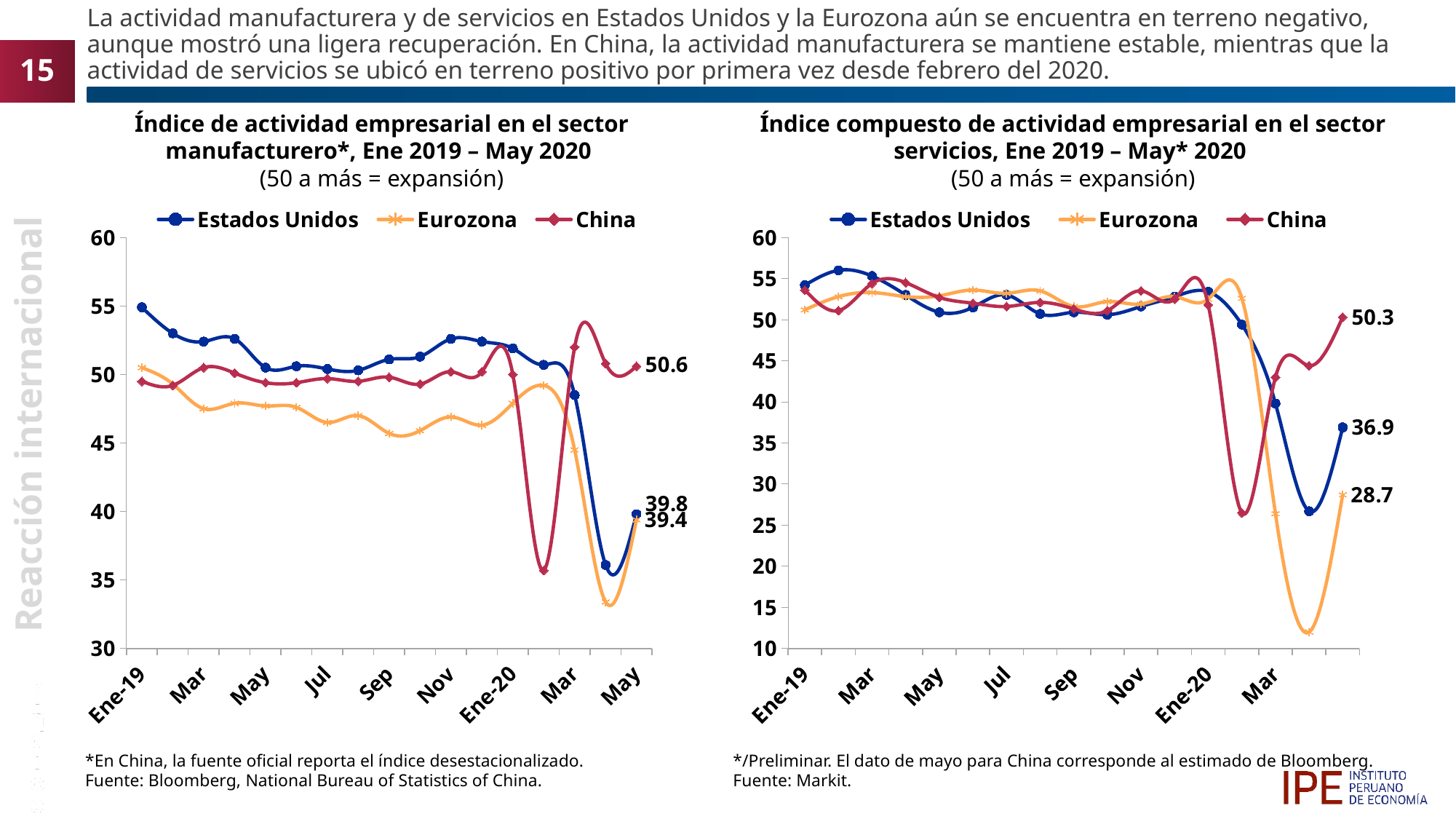
How many series does the legend of the left chart (sector manufacturero) list? 3 In the left chart (sector manufacturero), which series has the highest value in May 2020? China In the left chart (sector manufacturero), what is the value for Estados Unidos in May 2020? 39.8 In the right chart (sector servicios), is the value for Eurozona in April 2020 greater or less than 15? less In the left chart (Índice de actividad empresarial en el sector manufacturero), what is the value for China in May 2020? 50.6 In the right chart (sector servicios), what is the value for Eurozona in May 2020? 28.7 In the right chart (sector servicios), which series has the lowest value in May 2020? Eurozona In the right chart (sector servicios), what is the value for Estados Unidos in May 2020? 36.9 In the right chart (sector servicios), what is the value for China in May 2020? 50.3 In the right chart (sector servicios), what is the difference between the May 2020 values for China and Eurozona? 21.6 What kind of chart is the right chart (sector servicios)? Line chart In the left chart (sector manufacturero), what is the value for Eurozona in May 2020? 39.4